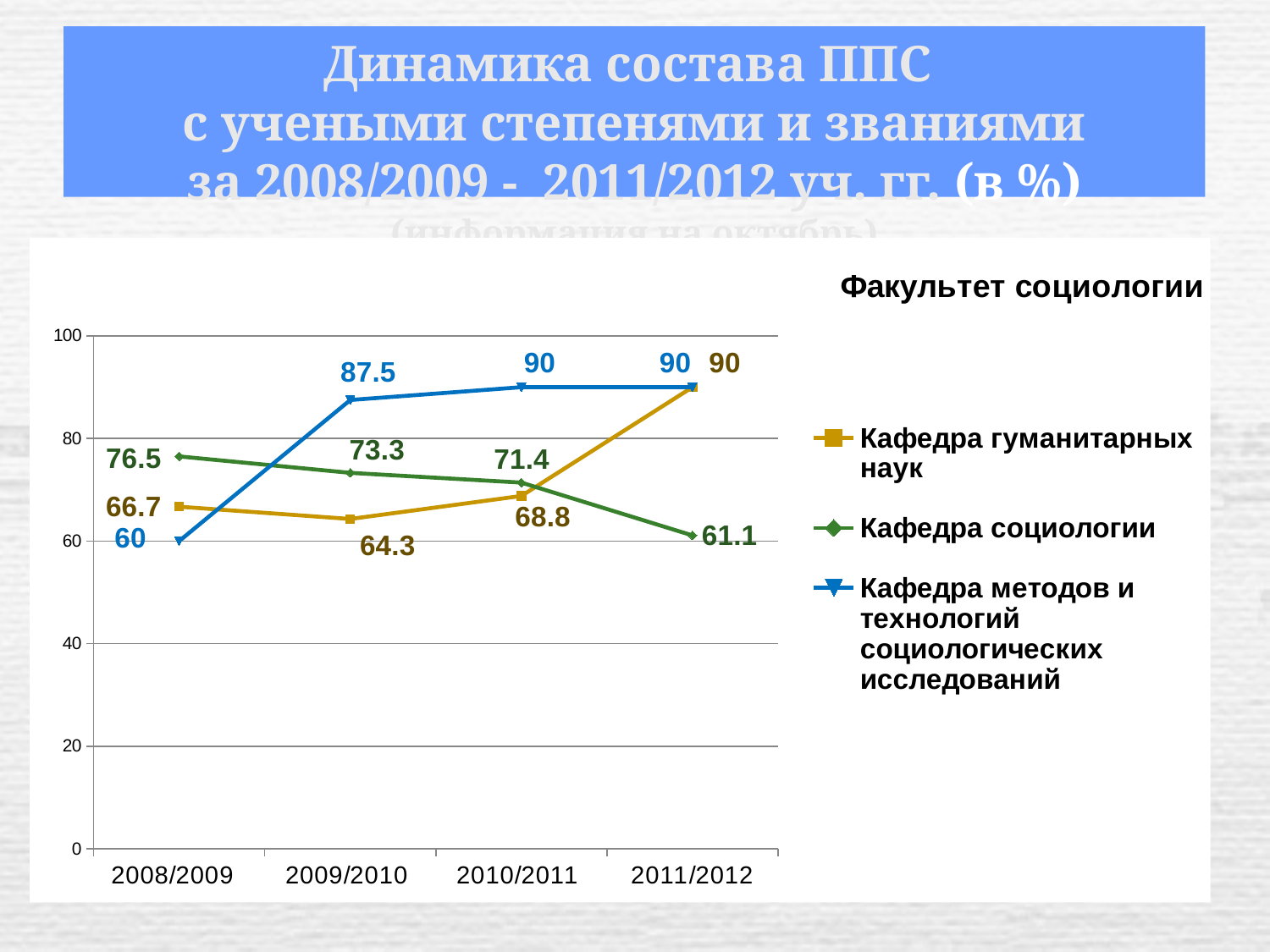
What is the difference between the values for Кафедра социологии and Кафедра гуманитарных наук in 2008/2009? 9.8 What is the value for Кафедра методов и технологий социологических исследований in 2009/2010? 87.5 In which year is the value for Кафедра гуманитарных наук highest? 2011/2012 Does the value for Кафедра социологии rise or fall from 2008/2009 to 2011/2012? fall What is the title shown above the chart legend? Факультет социологии How many series does the legend list? 3 What type of chart is shown on the slide? line chart Which series has the larger value in 2010/2011: Кафедра социологии or Кафедра гуманитарных наук? Кафедра социологии What is the value for Кафедра гуманитарных наук in 2009/2010? 64.3 What is the value for Кафедра социологии in 2008/2009? 76.5 In which year is the value for Кафедра социологии lowest? 2011/2012 How many academic years are shown on the x axis? 4